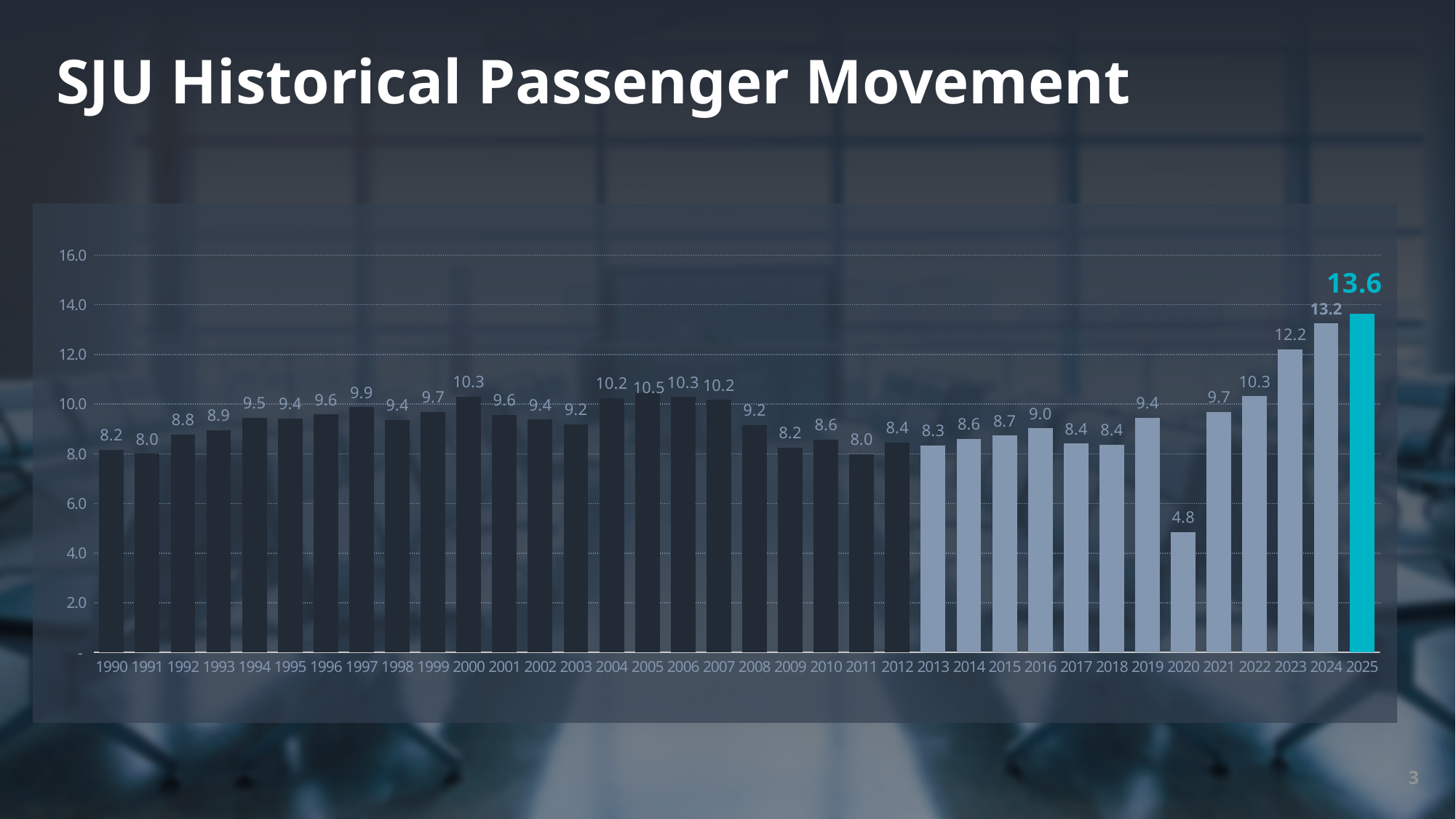
How many years are shown on the x axis? 36 Which year has the larger value, 2000 or 2013? 2000 Do the values rise or fall from 2020 to 2025? Rise What is the difference between the values for 2025 and 2024? 0.4 Is the value for 2024 greater or less than 12.0? greater What is the value shown for 2023? 12.2 What is the difference between the values for 2021 and 2020? 4.9 Which year has the highest value on the chart? 2025 Which year has the lowest value on the chart? 2020 What is the value shown for 2005? 10.5 What kind of chart is shown on the slide? Bar chart What is the value shown for 2020? 4.8